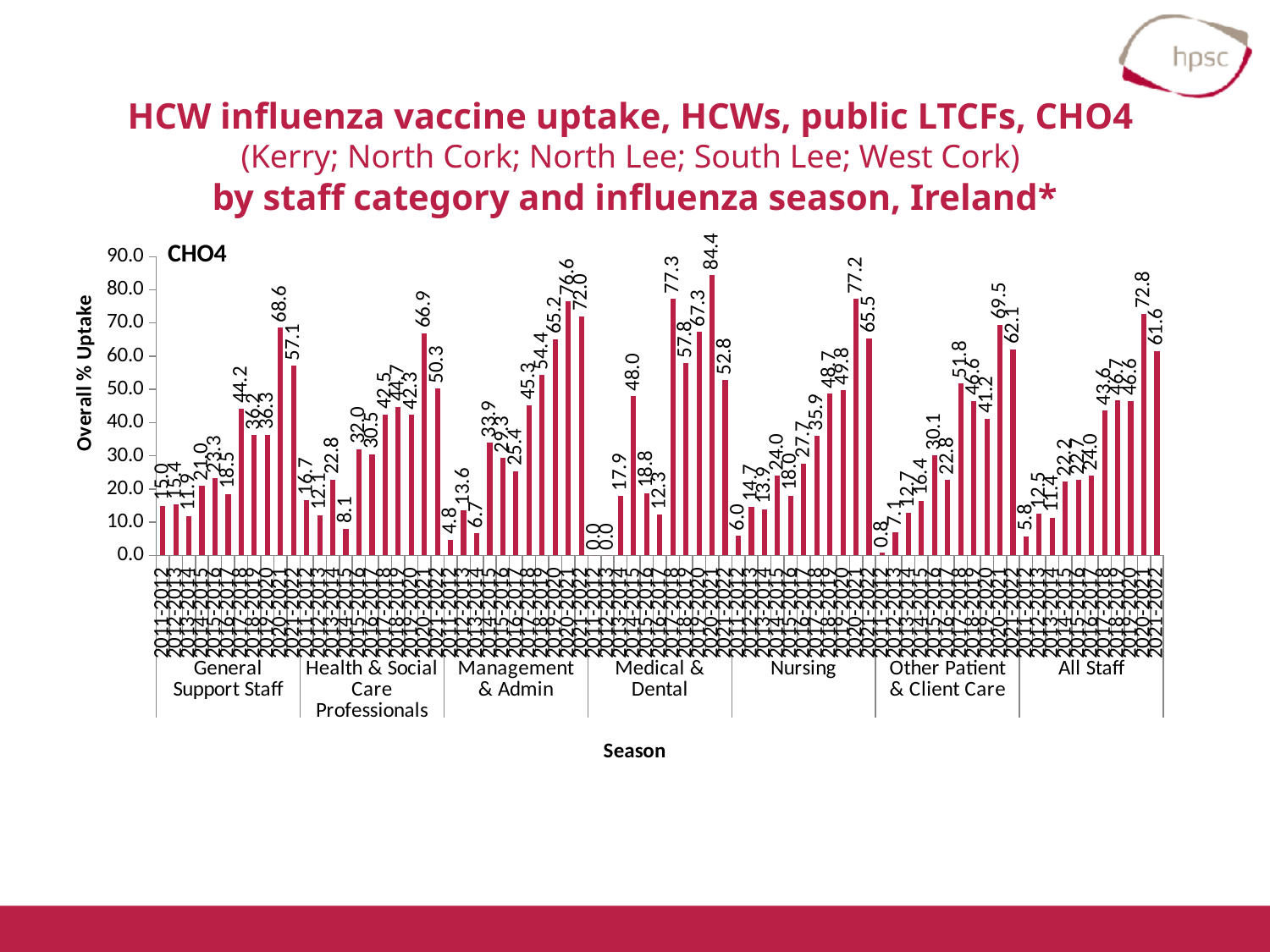
What is the label on the vertical axis of the chart? Overall % Uptake What is the difference between the All Staff values for 2020-2021 (72.8) and 2021-2022 (61.6)? 11.2 Is the highest value in the General Support Staff group greater or less than 60? greater What is the overall % uptake for All Staff in the 2020-2021 season (the second-to-last bar of the All Staff group)? 72.8 What is the highest value shown anywhere on the chart? 84.4 What is the overall % uptake for All Staff in the 2021-2022 season (the last bar of the All Staff group)? 61.6 Which is larger: the highest bar in the Nursing group or the highest bar in the Medical & Dental group? Medical & Dental What kind of chart is shown on the slide? Bar chart How many staff category groups are shown along the x axis? 7 Which staff category contains the highest bar on the chart? Medical & Dental What is the highest value in the Nursing group? 77.2 What is the lowest value in the Other Patient & Client Care group? 0.8